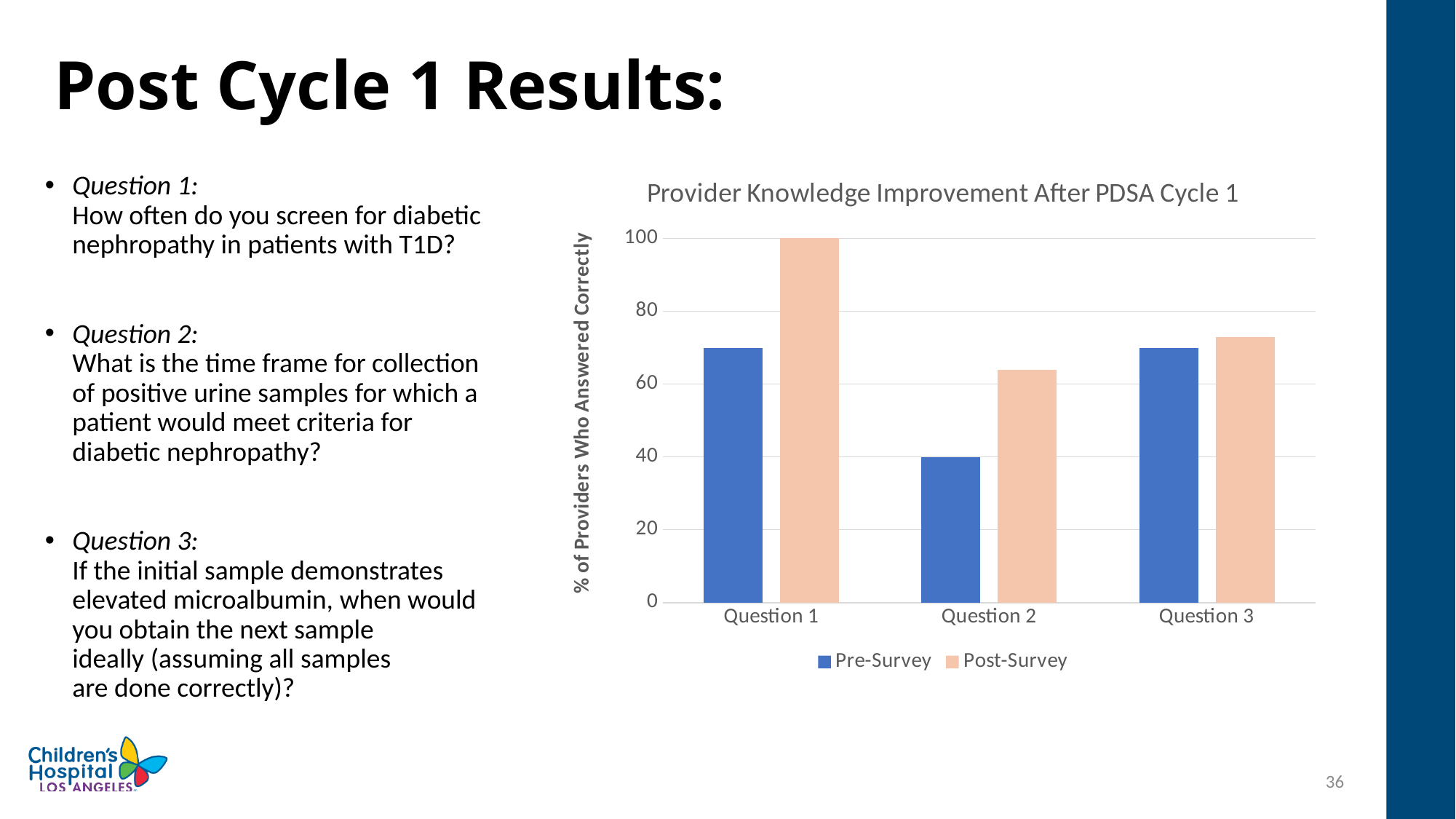
What is the title of the chart? Provider Knowledge Improvement After PDSA Cycle 1 How many series does the chart legend list? 2 Which question has the highest Post-Survey value? Question 1 How many question categories are shown on the x axis of the chart? 3 What does the y axis of the chart measure? % of Providers Who Answered Correctly Which question has the lowest Pre-Survey value? Question 2 Is the Pre-Survey value for Question 1 greater or less than 80? less What kind of chart is shown on the slide? bar chart For Question 2, which is larger, the Pre-Survey value or the Post-Survey value? Post-Survey Is the Post-Survey value for Question 2 greater or less than 60? greater What is the Pre-Survey value for Question 2? 40 What is the Post-Survey value for Question 1? 100